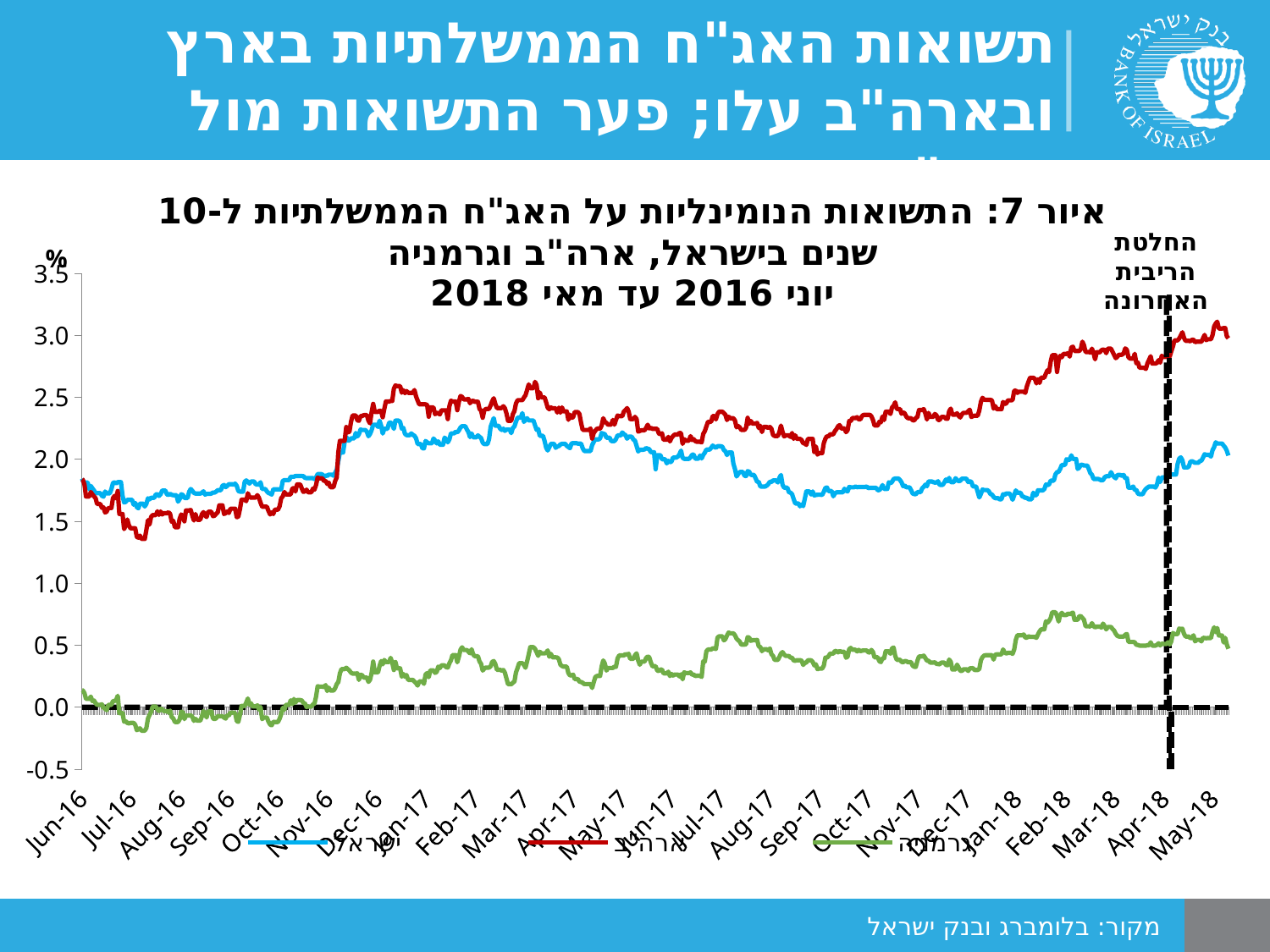
Does the ארה"ב series rise or fall between Sep-17 and Apr-18? rise Is the value for גרמניה in Aug-16 greater or less than 0.0? less How many series does the legend list? 3 How many month labels are shown on the x axis? 24 Which series has the lowest values across the whole period? גרמניה (green line) Which series has the highest value at the end of the chart (May-18)? ארה"ב (red line) What kind of chart is shown on the slide? Line chart Is the value for ארה"ב in May-18 greater or less than 2.5? greater In Apr-18, which series is higher, ארה"ב or ישראל? ארה"ב What does the vertical dashed line near Apr-18 mark, according to the annotation? החלטת הריבית האחרונה Is the value for ישראל in May-18 greater or less than 2.5? less